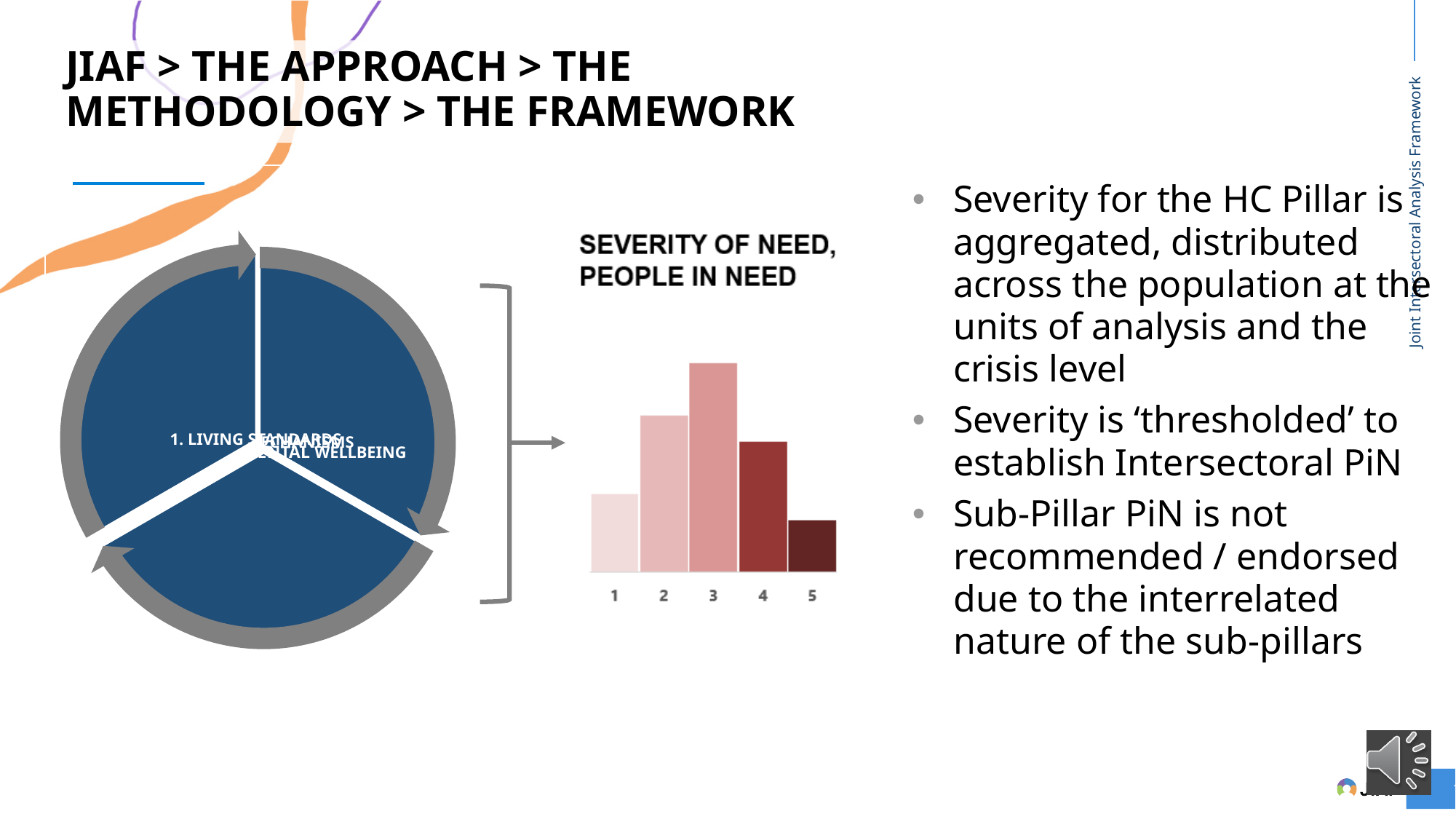
In the "SEVERITY OF NEED, PEOPLE IN NEED" bar chart, which bar is taller, category 1 or category 5? 1 What are the category labels on the x axis of the bar chart on the slide? 1, 2, 3, 4, 5 What is the title printed above the bar chart on the slide? SEVERITY OF NEED, PEOPLE IN NEED In the "SEVERITY OF NEED, PEOPLE IN NEED" bar chart, which bar is taller, category 2 or category 4? 2 How many bars does the "SEVERITY OF NEED, PEOPLE IN NEED" bar chart have? 5 In the "SEVERITY OF NEED, PEOPLE IN NEED" bar chart, which category has the tallest bar? 3 What kind of chart is shown under the heading "SEVERITY OF NEED, PEOPLE IN NEED"? bar chart In the "SEVERITY OF NEED, PEOPLE IN NEED" bar chart, do the bars rise or fall from category 3 to category 5? fall In the "SEVERITY OF NEED, PEOPLE IN NEED" bar chart, which category has the shortest bar? 5 In the "SEVERITY OF NEED, PEOPLE IN NEED" bar chart, do the bars rise or fall from category 1 to category 3? rise In the "SEVERITY OF NEED, PEOPLE IN NEED" bar chart, which bar is taller, category 3 or category 4? 3